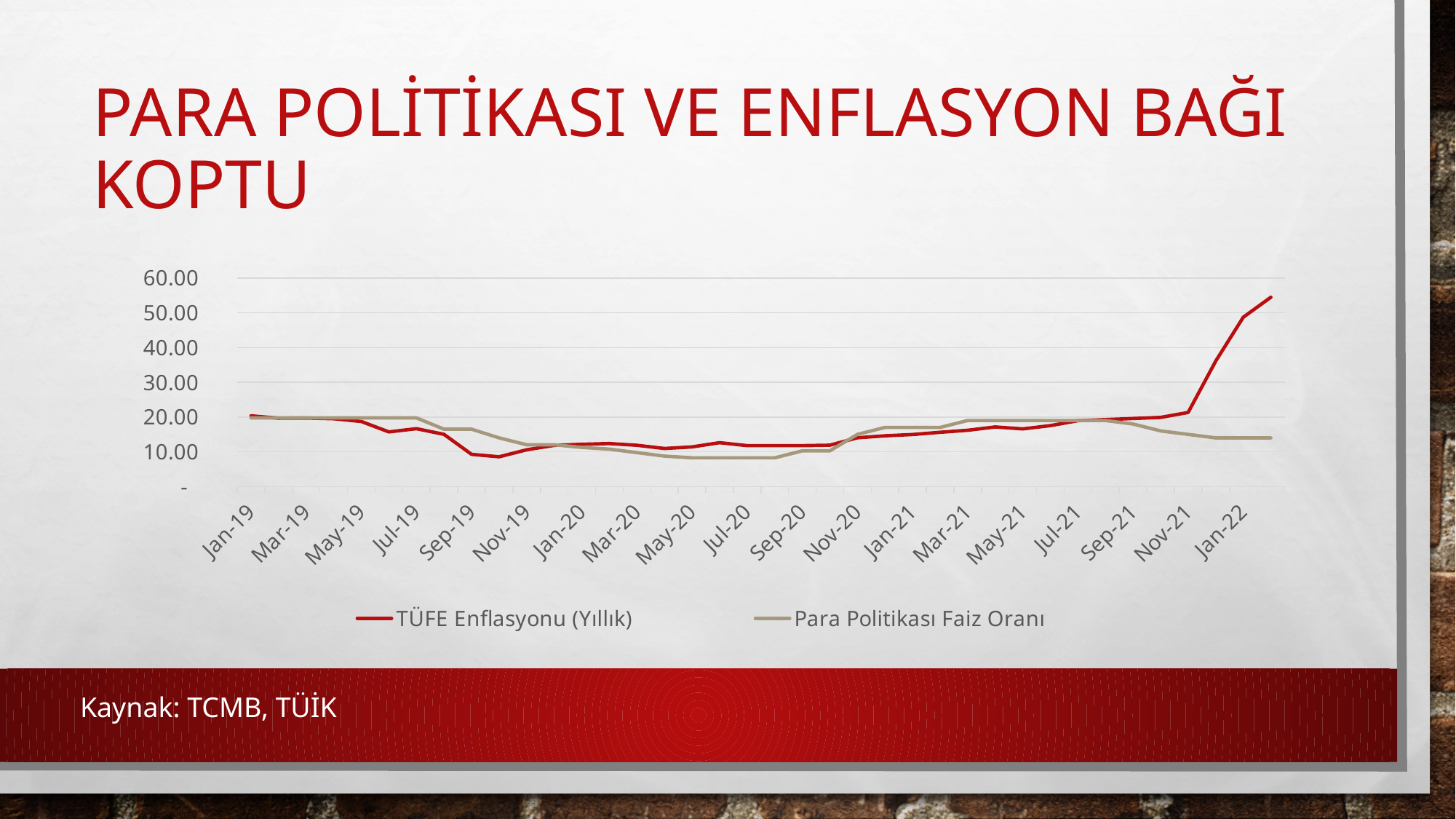
Is the value of TÜFE Enflasyonu (Yıllık) at Nov-19 greater or less than 20.00? less Is the value of TÜFE Enflasyonu (Yıllık) at Jan-22 greater or less than 40.00? greater How many series does the legend list? 2 What kind of chart is shown on the slide? line chart At Jul-20, which series has the higher value, TÜFE Enflasyonu (Yıllık) or Para Politikası Faiz Oranı? TÜFE Enflasyonu (Yıllık) What colour is the line for TÜFE Enflasyonu (Yıllık)? red Is the value of Para Politikası Faiz Oranı at Jan-22 greater or less than 20.00? less At Jan-22, which series has the higher value, TÜFE Enflasyonu (Yıllık) or Para Politikası Faiz Oranı? TÜFE Enflasyonu (Yıllık) Does the Para Politikası Faiz Oranı line rise or fall between Sep-21 and Jan-22? fall Does the TÜFE Enflasyonu (Yıllık) line rise or fall between Sep-21 and Jan-22? rise What are the two series named in the legend? TÜFE Enflasyonu (Yıllık) and Para Politikası Faiz Oranı